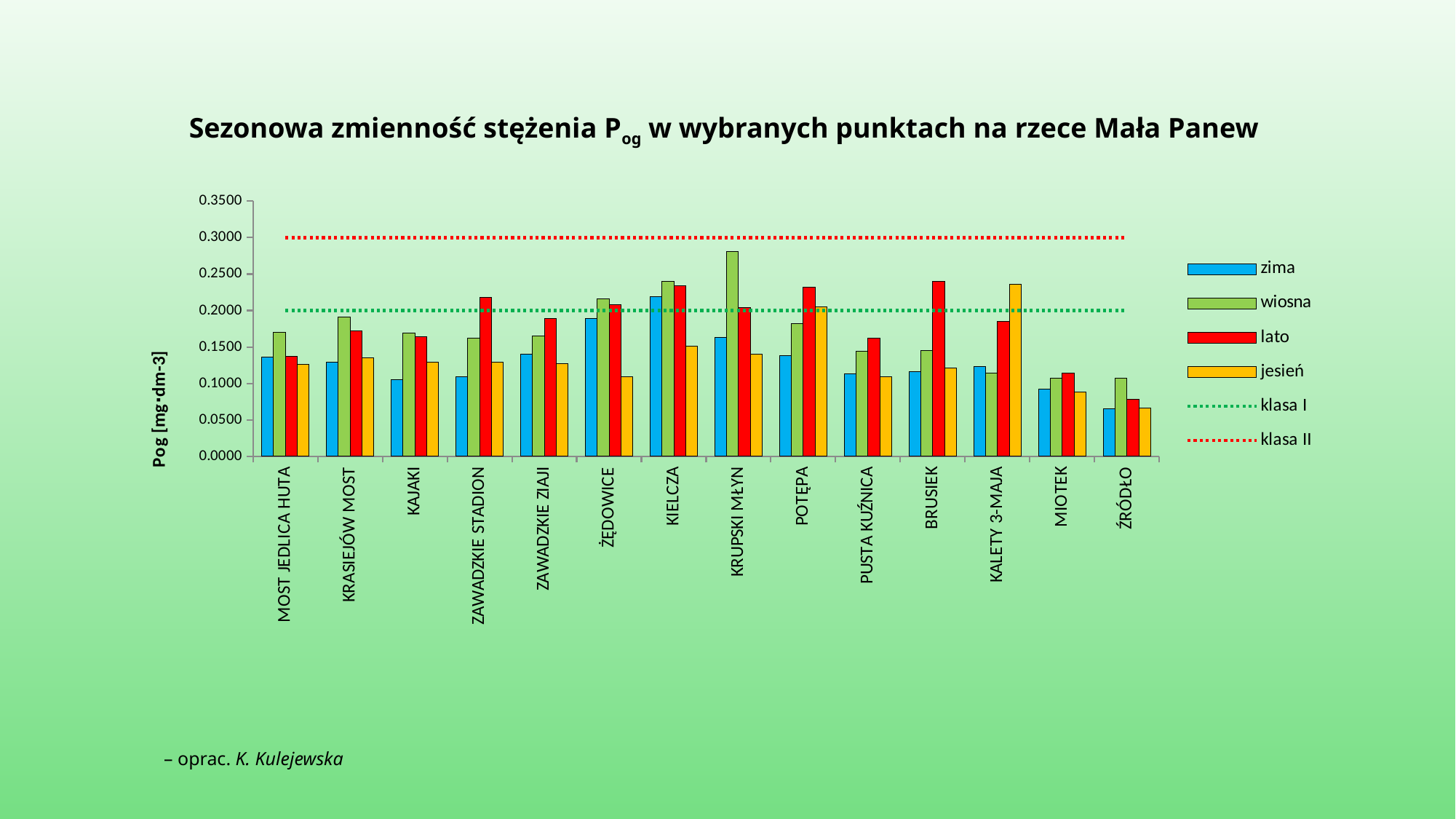
How many entries does the legend list? 6 How many measurement stations (categories) are shown on the x axis? 14 Which station has the highest bar of all in the chart? KRUPSKI MŁYN Which season has the highest value at KRUPSKI MŁYN? wiosna At what value on the y axis is the dotted klasa II line drawn? 0.3000 Is the jesień value for KALETY 3-MAJA greater or less than 0.2000? greater Which station has the larger zima value, KIELCZA or MIOTEK? KIELCZA Which station has the lowest zima value? ŹRÓDŁO Which is larger at BRUSIEK, the lato value or the zima value? lato Is the wiosna value for KRUPSKI MŁYN greater or less than 0.2500? greater What kind of chart is shown on the slide? bar chart Is the zima value for ŹRÓDŁO greater or less than 0.1000? less